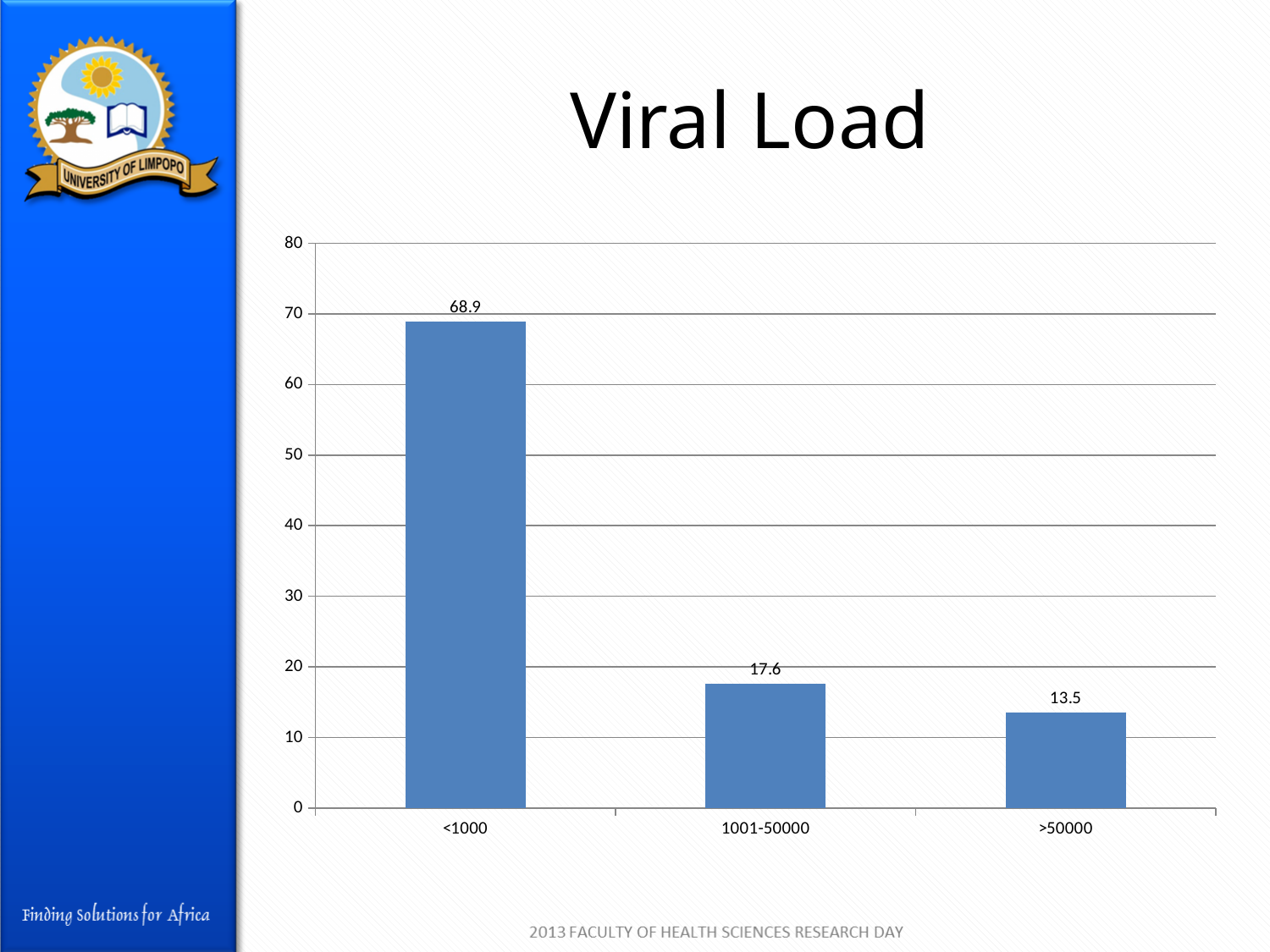
How many categories are shown on the x axis? 3 What is the difference between the values for <1000 and 1001-50000? 51.3 Which is larger, the value for 1001-50000 or the value for >50000? 1001-50000 What is the value for the >50000 category? 13.5 What kind of chart is shown on the slide? bar chart What is the value for the <1000 category? 68.9 What is the value for the 1001-50000 category? 17.6 Which category has the highest value? <1000 Which category has the lowest value? >50000 Do the values rise or fall from left to right along the x axis? fall Is the value for <1000 greater or less than 60? greater What is the difference between the values for 1001-50000 and >50000? 4.1